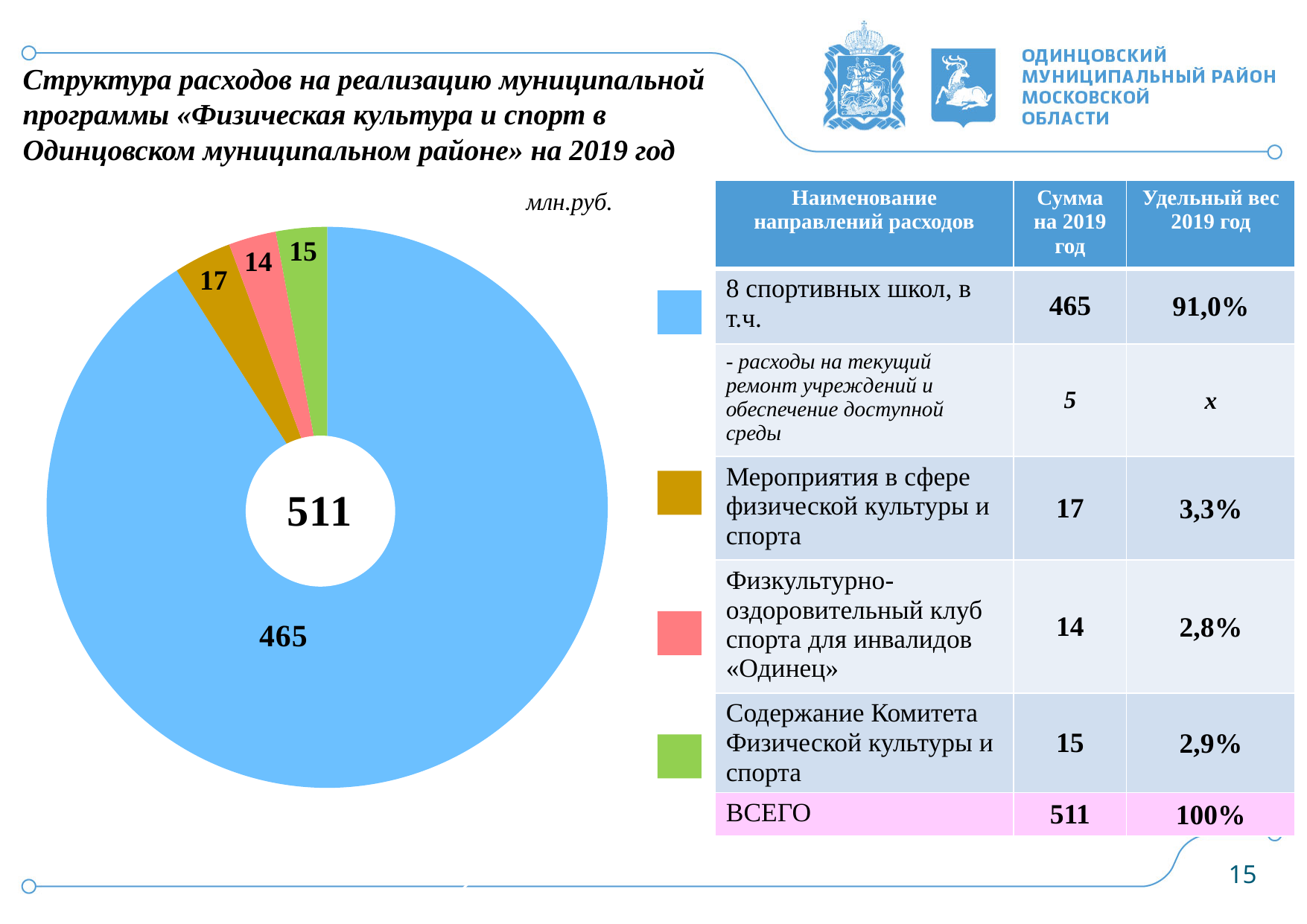
What type of chart is shown on the slide? Doughnut (pie) chart Which is larger: the slice for Содержание Комитета Физической культуры и спорта or the slice for Физкультурно-оздоровительный клуб «Одинец»? Содержание Комитета Физической культуры и спорта What value is shown for the slice 'Содержание Комитета Физической культуры и спорта'? 15 Which category has the largest slice in the chart? 8 спортивных школ What is the value shown for the largest slice of the chart (8 спортивных школ)? 465 What value is shown for the slice 'Мероприятия в сфере физической культуры и спорта'? 17 How many slices does the doughnut chart have? 4 What value is shown for the slice 'Физкультурно-оздоровительный клуб спорта для инвалидов «Одинец»'? 14 What total is printed in the centre of the doughnut chart? 511 What share of the total does the slice for 8 спортивных школ represent, according to the table? 91,0% What is the difference between the value for 8 спортивных школ and the value for Мероприятия в сфере физической культуры и спорта? 448 Which category has the smallest slice in the chart? Физкультурно-оздоровительный клуб спорта для инвалидов «Одинец»